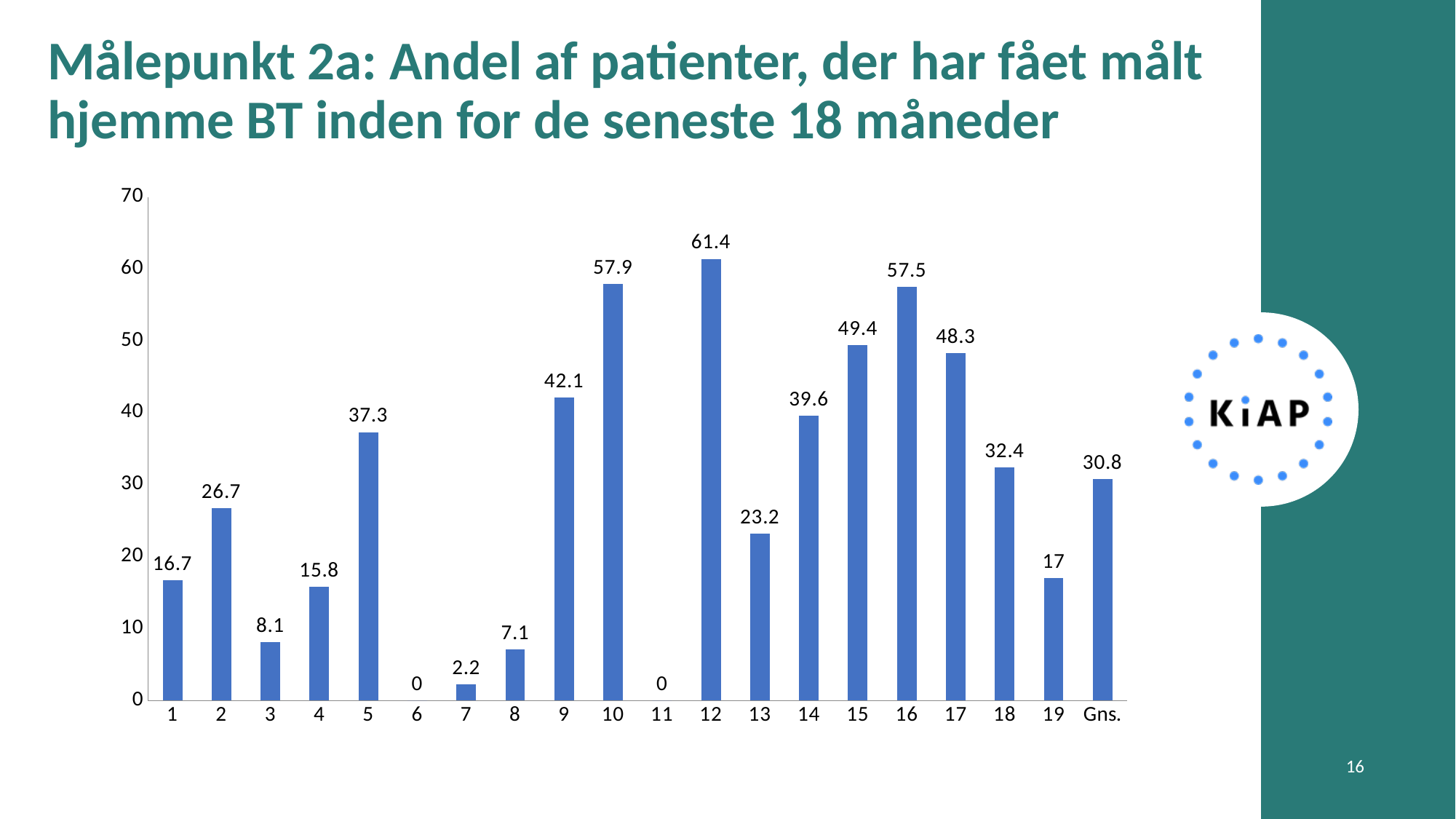
What is the value for Gns.? 30.8 What is the value for category 19? 17 Is the value for category 9 greater or less than 40? greater What type of chart is shown on the slide? bar chart What is the value for category 12? 61.4 Which is larger, the value for category 15 or the value for category 17? 15 What is the difference between the values for category 10 and category 16? 0.4 What is the value for category 5? 37.3 How many categories are shown on the x axis? 20 Which category has the highest value? 12 What is the difference between the value for category 12 and the Gns. value? 30.6 How many categories have a value of 0? 2